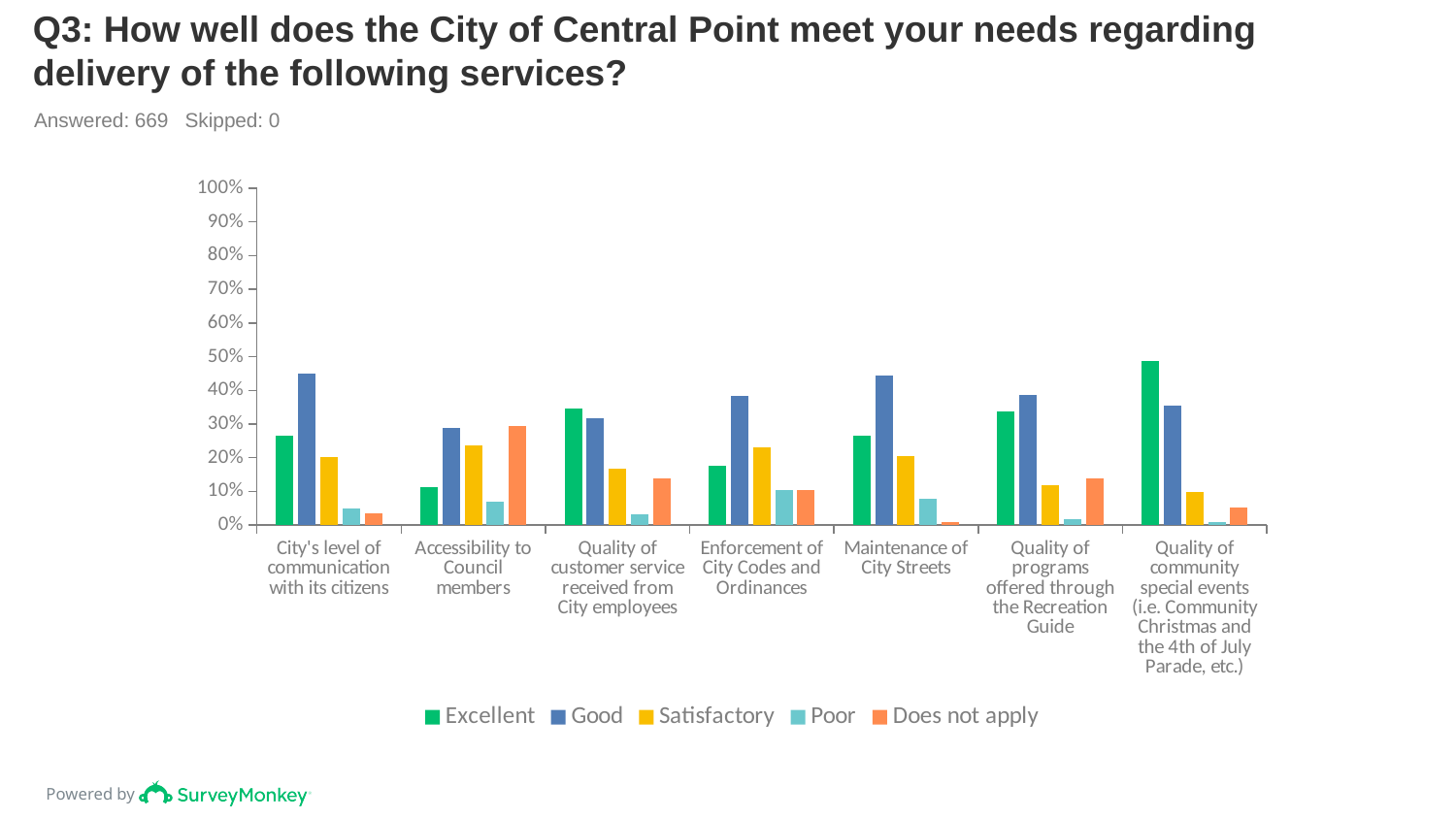
Which has the larger Does not apply value: Accessibility to Council members or City's level of communication with its citizens? Accessibility to Council members Is the Excellent value for Quality of community special events greater or less than 40%? greater Is the Good value for Enforcement of City Codes and Ordinances greater or less than 30%? greater How many series does the legend list? 5 Is the Excellent value for Accessibility to Council members greater or less than 20%? less For Maintenance of City Streets, which is larger: the Excellent value or the Good value? Good Which service category has the lowest Excellent value? Accessibility to Council members What kind of chart is shown on the slide? bar chart How many service categories are shown along the x axis? 7 Which service category has the highest Excellent value? Quality of community special events Which series is shown in orange in the legend? Does not apply